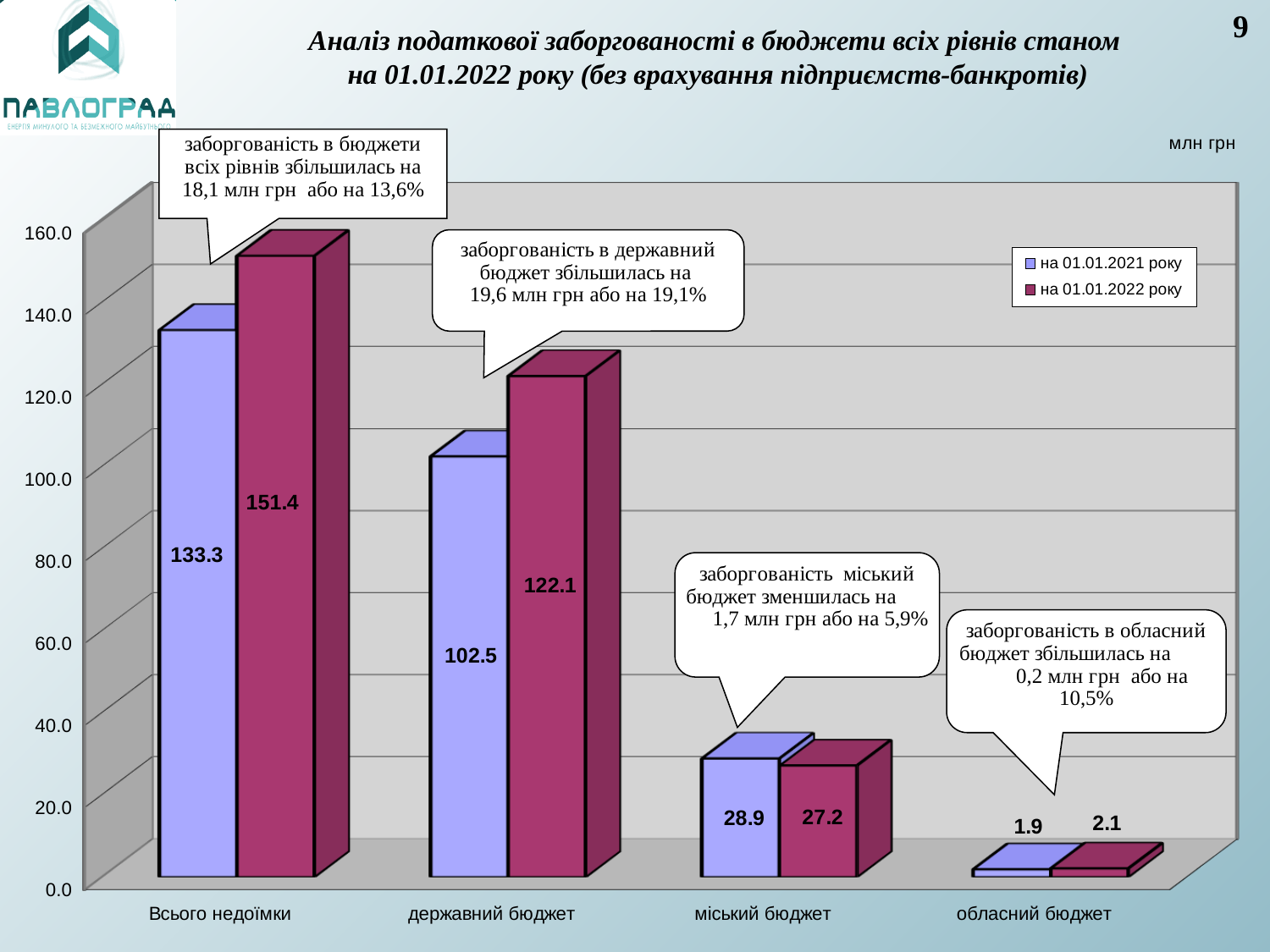
For міський бюджет, which is larger: the value на 01.01.2021 року or на 01.01.2022 року? на 01.01.2021 року What is the difference between the на 01.01.2022 року and на 01.01.2021 року values for державний бюджет? 19.6 How many categories are shown on the x axis? 4 What is the value for міський бюджет на 01.01.2022 року? 27.2 What is the value for державний бюджет на 01.01.2021 року? 102.5 How many series does the legend list? 2 Which category has the lowest value for на 01.01.2022 року? обласний бюджет What is the value for Всього недоїмки на 01.01.2022 року? 151.4 What is the value for обласний бюджет на 01.01.2021 року? 1.9 Which category has the highest value for на 01.01.2021 року? Всього недоїмки What kind of chart is shown on the slide? bar chart What unit is indicated in the top right corner of the chart? млн грн